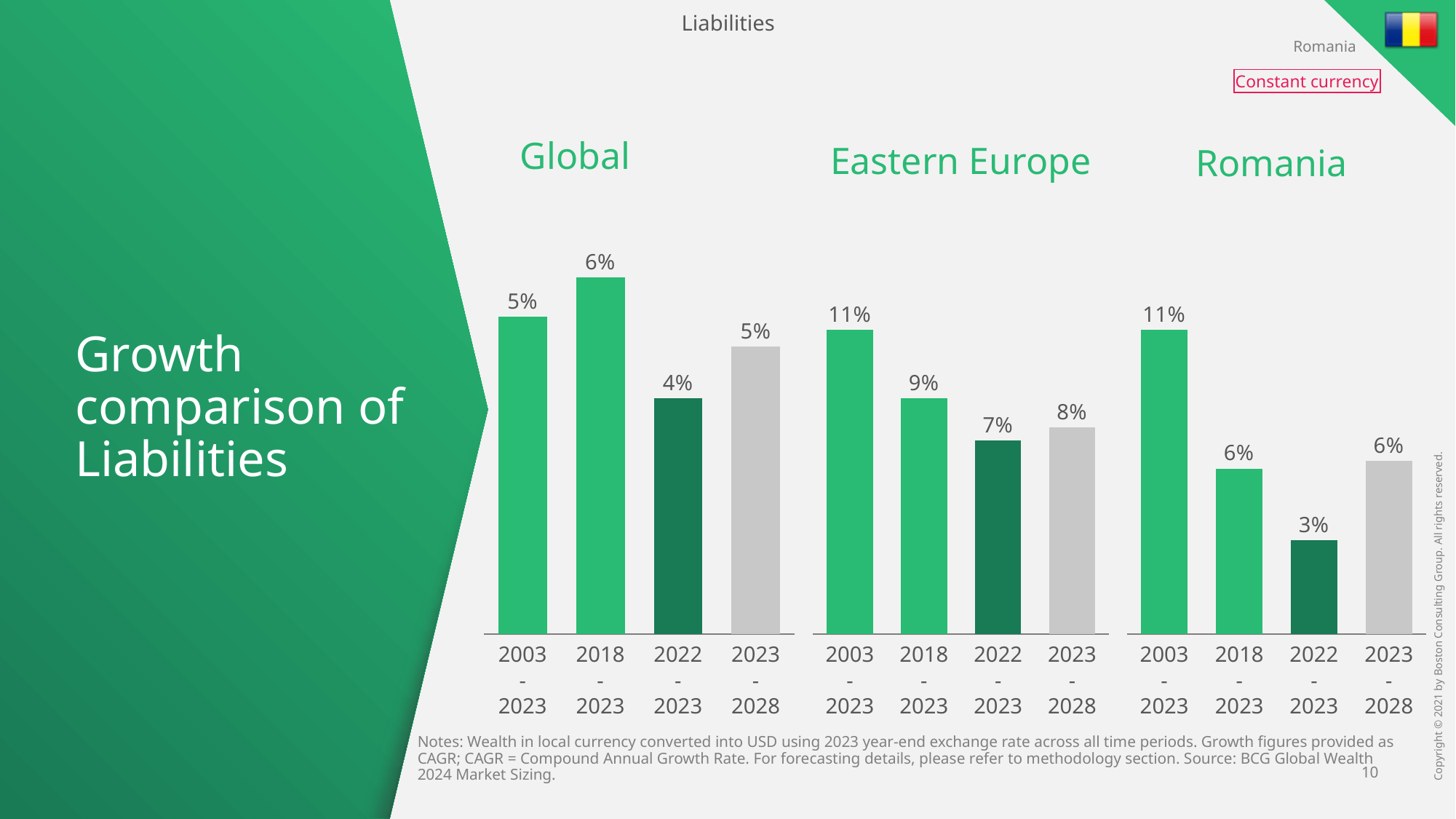
In the Romania chart, what is the value for 2022-2023? 3% In the Romania chart, which period has the highest value? 2003-2023 In the Eastern Europe chart, what is the difference between the 2003-2023 value and the 2022-2023 value? 4% What kind of chart is the Eastern Europe chart? Bar chart How many charts are shown on the slide? 3 In the Romania chart, do the values rise or fall from 2003-2023 to 2022-2023? Fall Which is larger: the 2022-2023 value in the Eastern Europe chart or the 2022-2023 value in the Romania chart? Eastern Europe In the Global chart, what is the value for 2018-2023? 6% In the Eastern Europe chart, what is the value for 2023-2028? 8% In the Romania chart, what is the difference between the 2003-2023 value and the 2018-2023 value? 5% How many periods are shown in the Global chart? 4 In the Global chart, which period has the lowest value? 2022-2023